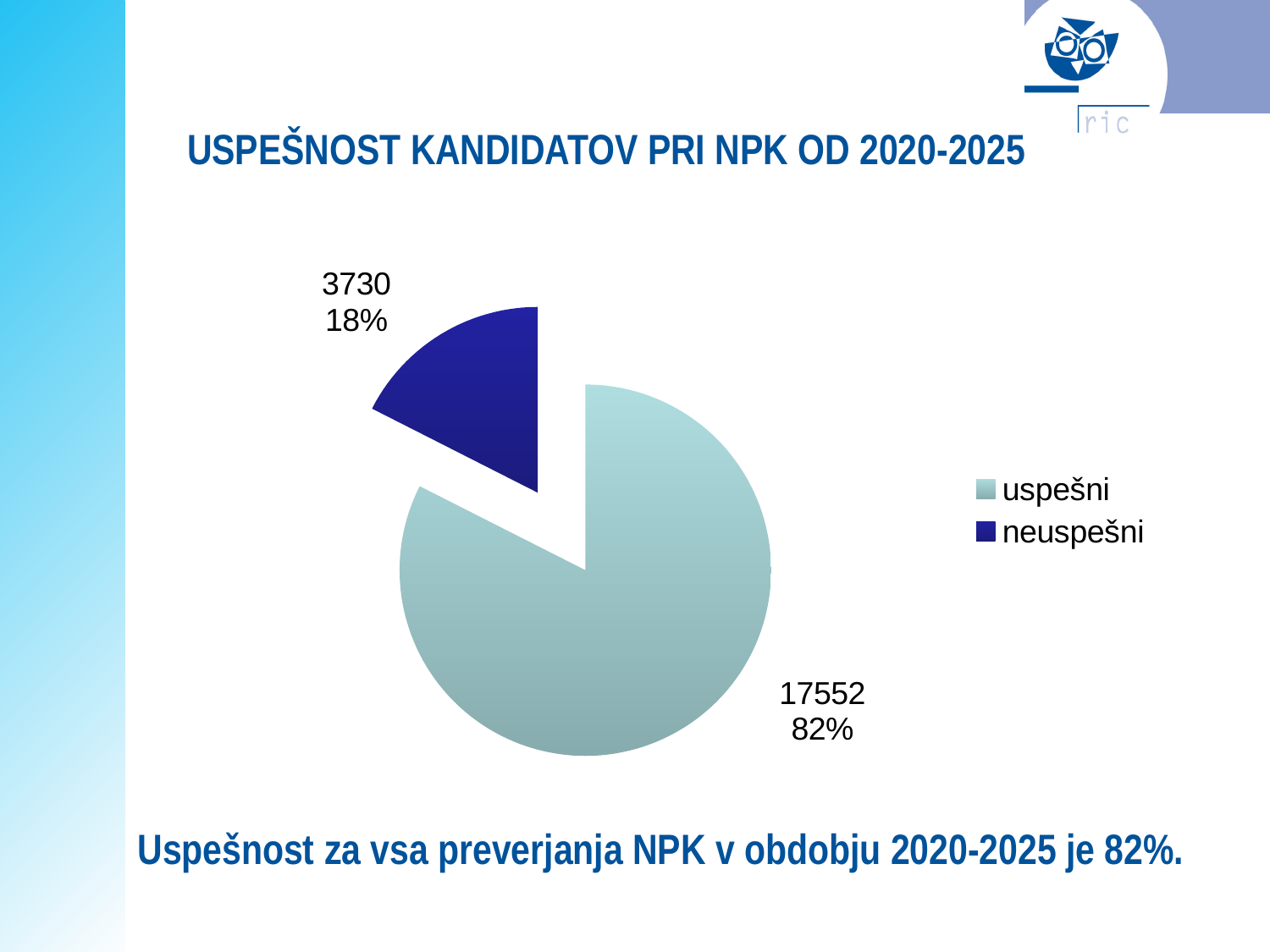
What is the total of the two slices? 21282 Which category has the smallest slice? neuspešni What kind of chart is shown on the slide? pie chart What is the value for neuspešni? 3730 Which category has the largest slice? uspešni What share of the pie does the neuspešni slice represent? 18% What is the value for uspešni? 17552 Which is larger, uspešni or neuspešni? uspešni How many entries does the legend list? 2 What is the difference between the uspešni and neuspešni values? 13822 How many slices does the pie chart have? 2 What share of the pie does the uspešni slice represent? 82%